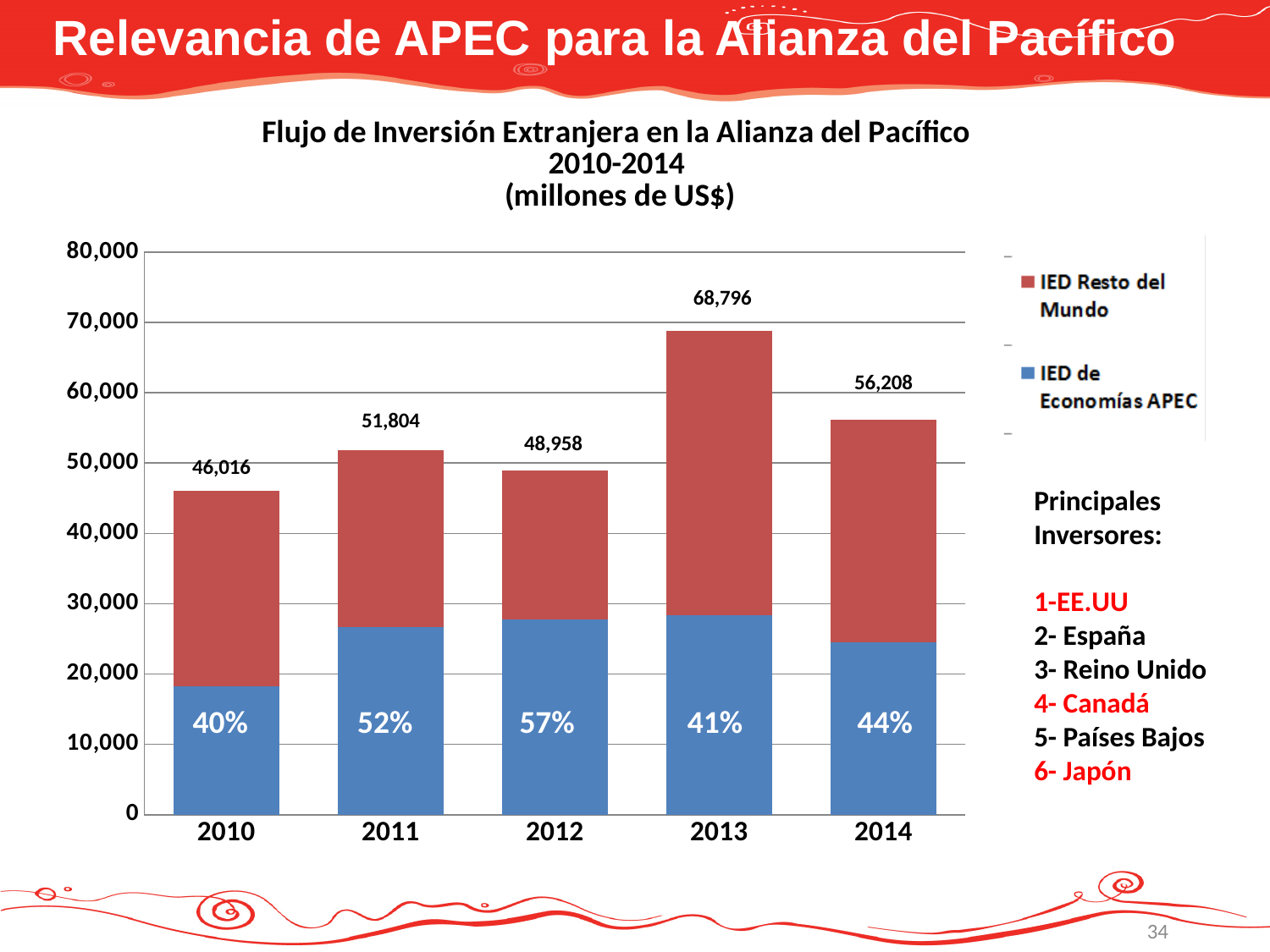
What is the total foreign investment flow shown for 2013? 68,796 What is the total value labeled above the bar for 2010? 46,016 Which year has the highest total foreign investment flow? 2013 Is the IED de Economías APEC segment for 2010 greater or less than 20,000? less Which year has the lowest total foreign investment flow? 2010 What are the two series named in the legend? IED Resto del Mundo and IED de Economías APEC What kind of chart is shown on the slide? Stacked bar chart What is the difference between the total for 2013 and the total for 2014? 12,588 What percentage is printed on the IED de Economías APEC segment for 2012? 57% How many years are shown on the x axis of the chart? 5 How many series does the legend list? 2 Which total is larger, 2011 or 2012? 2011